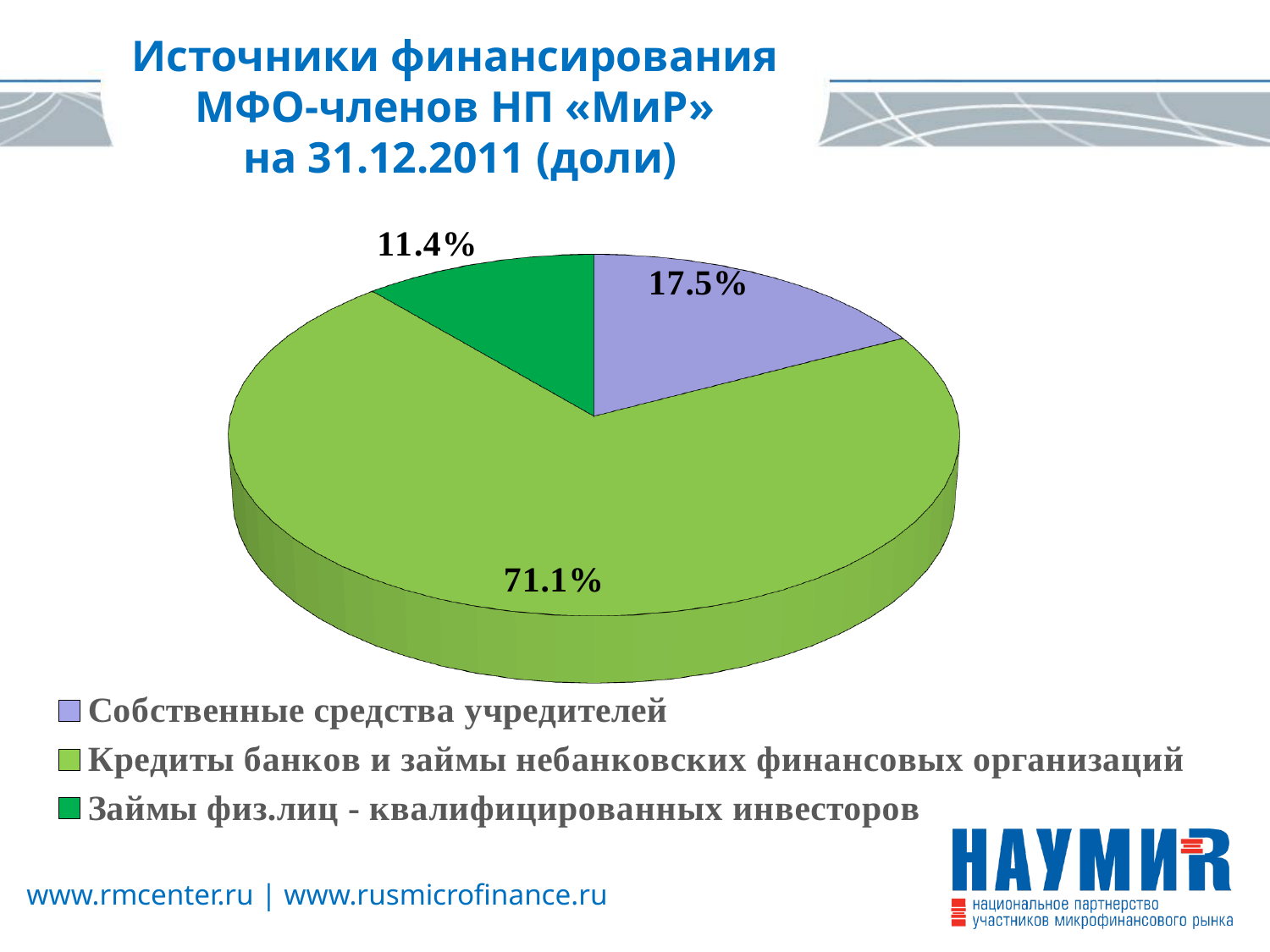
What colour is the slice for Займы физ.лиц - квалифицированных инвесторов? dark green Which is larger: the share for Собственные средства учредителей or the share for Займы физ.лиц - квалифицированных инвесторов? Собственные средства учредителей How many slices does the pie chart have? 3 What share of funding comes from Кредиты банков и займы небанковских финансовых организаций? 71.1% Which funding source has the smallest share? Займы физ.лиц - квалифицированных инвесторов What share of funding comes from Займы физ.лиц - квалифицированных инвесторов? 11.4% Which funding source has the largest share? Кредиты банков и займы небанковских финансовых организаций What is the difference in percentage points between Кредиты банков и займы небанковских финансовых организаций and Собственные средства учредителей? 53.6 What is the difference in percentage points between Собственные средства учредителей and Займы физ.лиц - квалифицированных инвесторов? 6.1 How many entries does the legend list? 3 What share of funding comes from Собственные средства учредителей? 17.5% What kind of chart is shown on the slide? pie chart